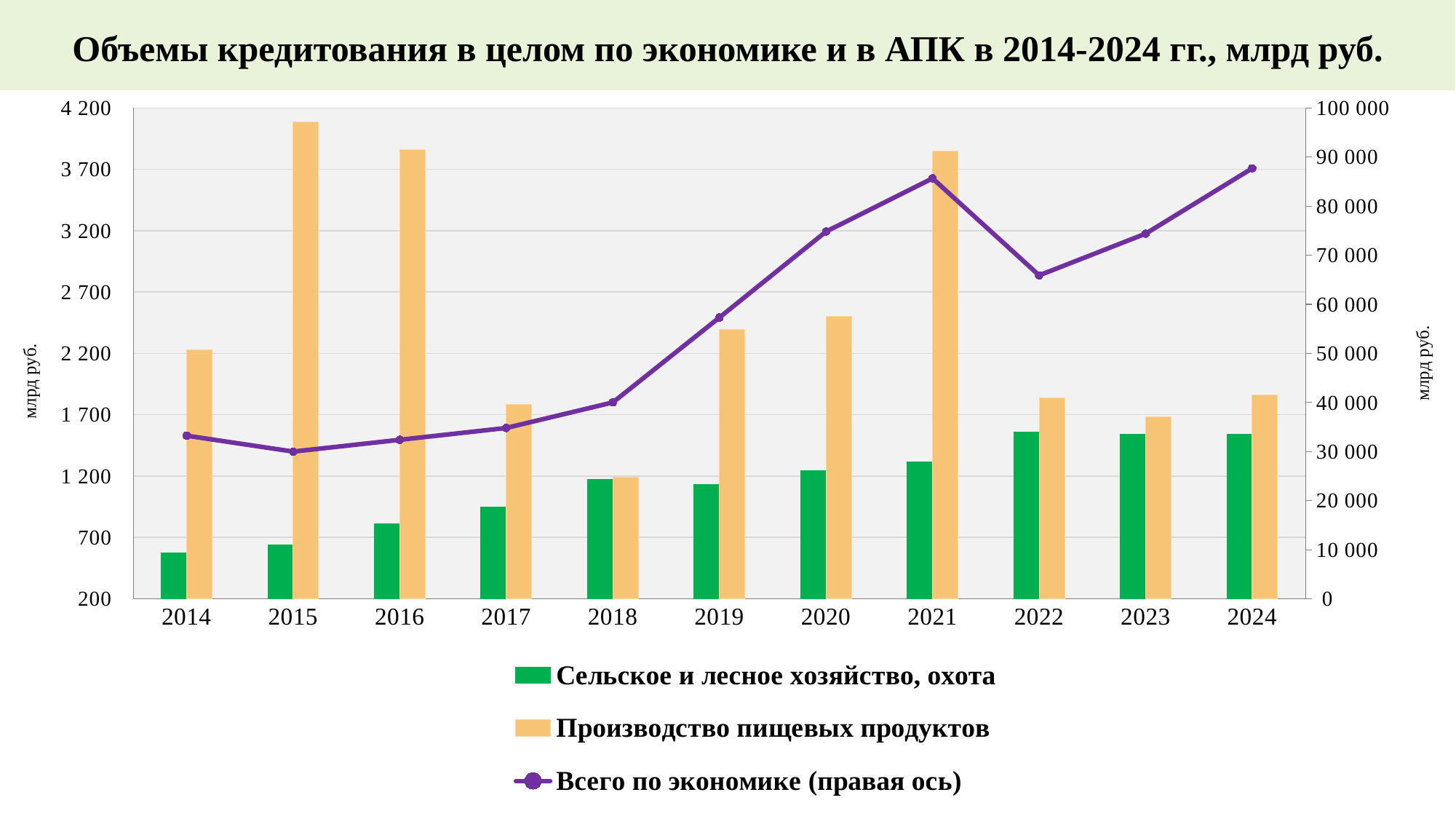
In which year is the value for Производство пищевых продуктов highest? 2015 Which series is plotted on the right axis according to the legend? Всего по экономике (правая ось) In which year is the value for Производство пищевых продуктов lowest? 2018 How many years are shown on the x axis of the chart? 11 Is the value for Всего по экономике (правая ось) in 2022 greater or less than 70 000? less How many series does the legend list? 3 What kind of chart is shown on the slide? Combined bar and line chart In which year is the value for Всего по экономике (правая ось) lowest? 2015 Is the value for Производство пищевых продуктов in 2015 greater or less than 3 700? greater Is the value for Сельское и лесное хозяйство, охота in 2014 greater or less than 700? less In which year is the value for Сельское и лесное хозяйство, охота lowest? 2014 In 2019, which is larger: Сельское и лесное хозяйство, охота or Производство пищевых продуктов? Производство пищевых продуктов